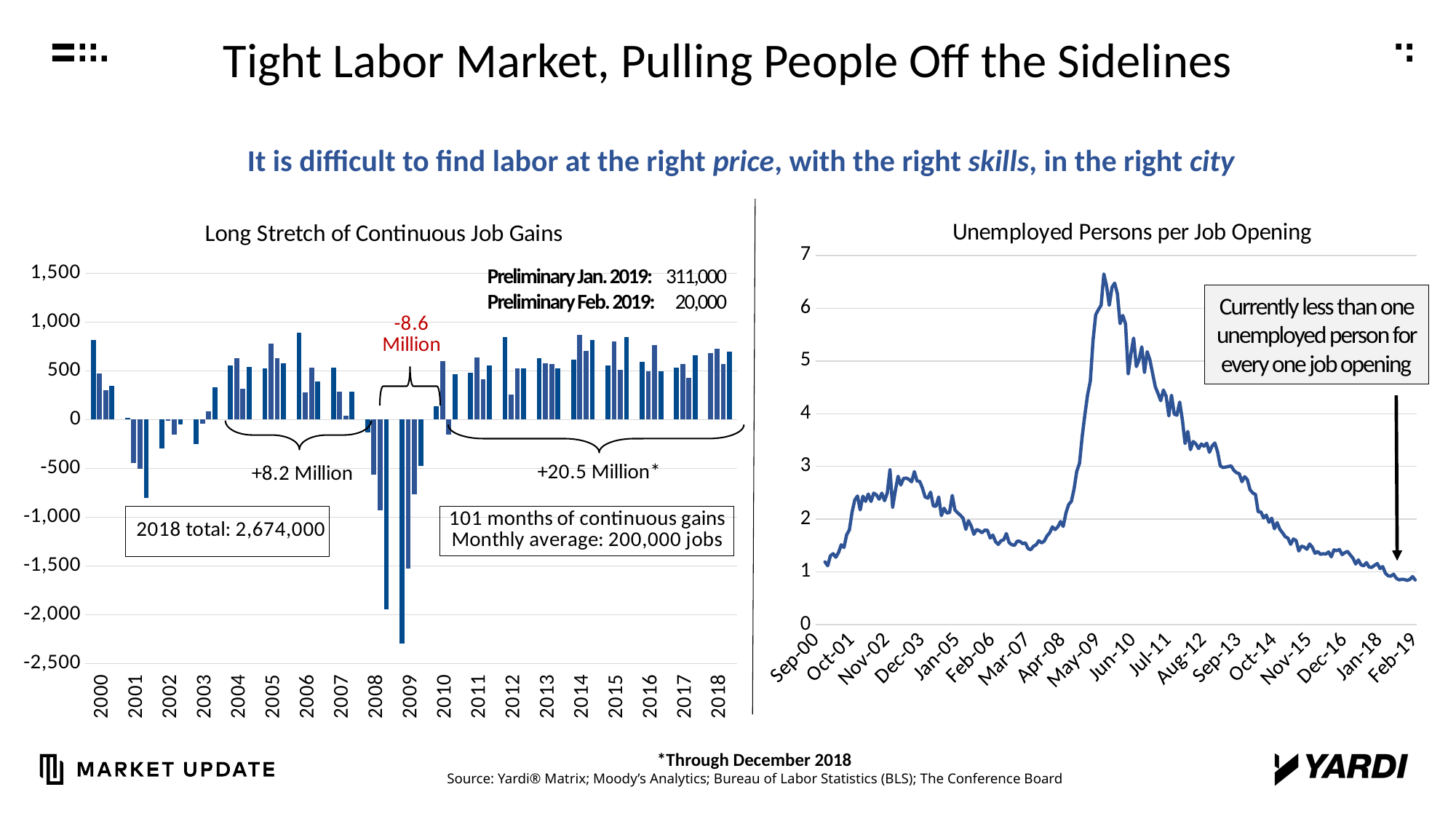
In the "Unemployed Persons per Job Opening" chart, is the value for Feb-19 greater or less than 1? less In the "Long Stretch of Continuous Job Gains" chart, what job change is labeled for the 2008–2009 period? -8.6 Million What kind of chart is "Long Stretch of Continuous Job Gains"? Bar chart In the "Unemployed Persons per Job Opening" chart, is the peak value around 2009–2010 greater or less than 6? greater What kind of chart is "Unemployed Persons per Job Opening"? Line chart In the "Unemployed Persons per Job Opening" chart, do values rise or fall from Jun-10 to Feb-19? Fall In the "Long Stretch of Continuous Job Gains" chart, what is the stated monthly average of job gains over the 101 months of continuous gains? 200,000 jobs In the "Long Stretch of Continuous Job Gains" chart, what job gain is labeled for the period from 2010 onward? +20.5 Million In the "Long Stretch of Continuous Job Gains" chart, what is the 2018 total of job gains? 2,674,000 In the "Long Stretch of Continuous Job Gains" chart, what is the preliminary job gain figure for Jan. 2019? 311,000 In the "Long Stretch of Continuous Job Gains" chart, what job gain is labeled for the 2004–2007 period? +8.2 Million In the "Long Stretch of Continuous Job Gains" chart, what is the preliminary job gain figure for Feb. 2019? 20,000